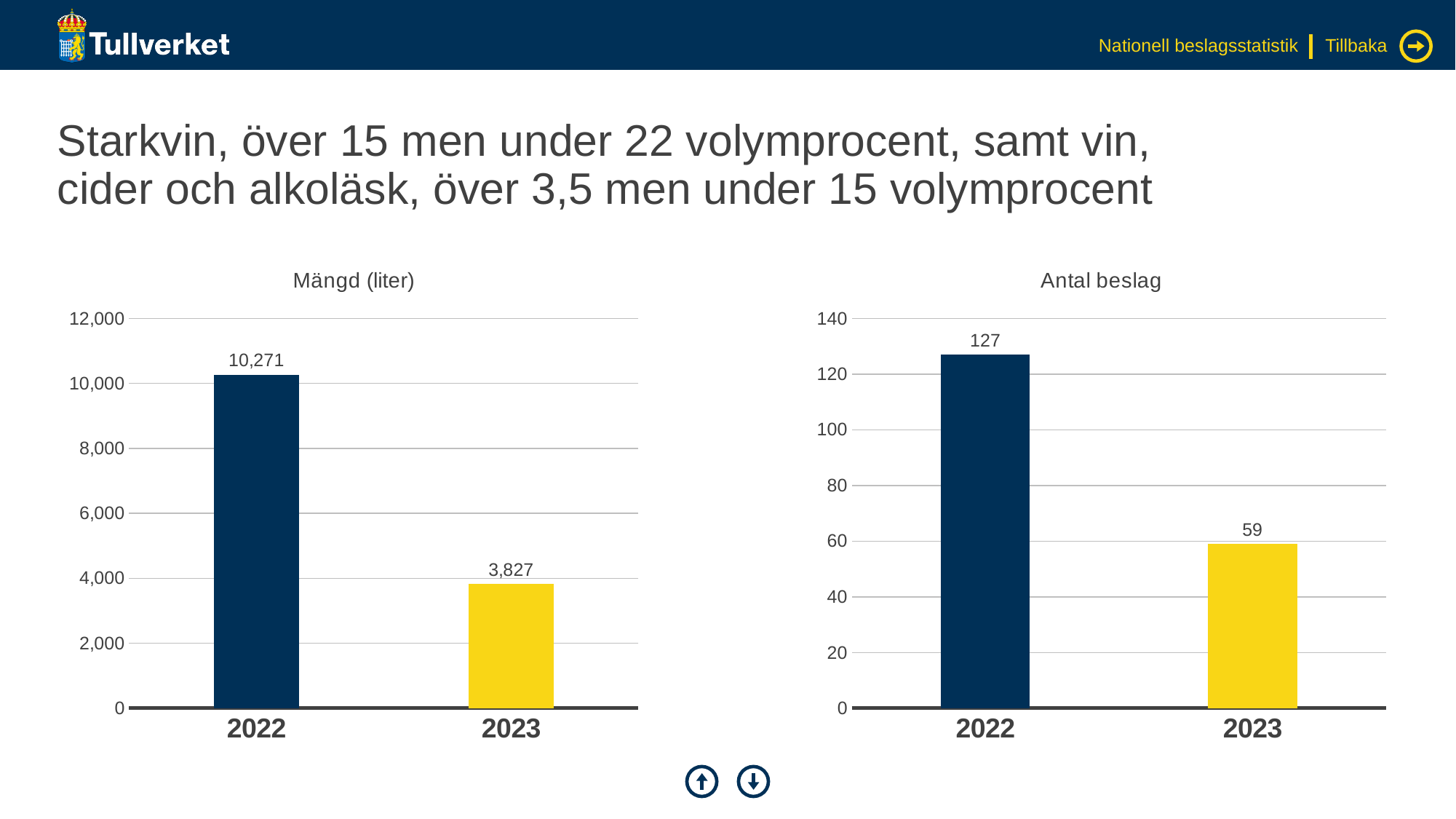
In the 'Mängd (liter)' chart, how many years are shown on the x axis? 2 In the 'Antal beslag' chart, what is the value for 2022? 127 In the 'Mängd (liter)' chart, what is the value for 2022? 10,271 In the 'Antal beslag' chart, what is the value for 2023? 59 In the 'Mängd (liter)' chart, which year has the highest value? 2022 In the 'Mängd (liter)' chart, what is the value for 2023? 3,827 In the 'Mängd (liter)' chart, what is the difference between the 2022 and 2023 values? 6,444 In the 'Antal beslag' chart, is the value for 2022 greater or less than 120? greater What kind of chart is the 'Antal beslag' chart? bar chart In the 'Antal beslag' chart, what is the difference between the 2022 and 2023 values? 68 In the 'Antal beslag' chart, which year has the lowest value? 2023 In the 'Mängd (liter)' chart, do the values rise or fall from 2022 to 2023? fall